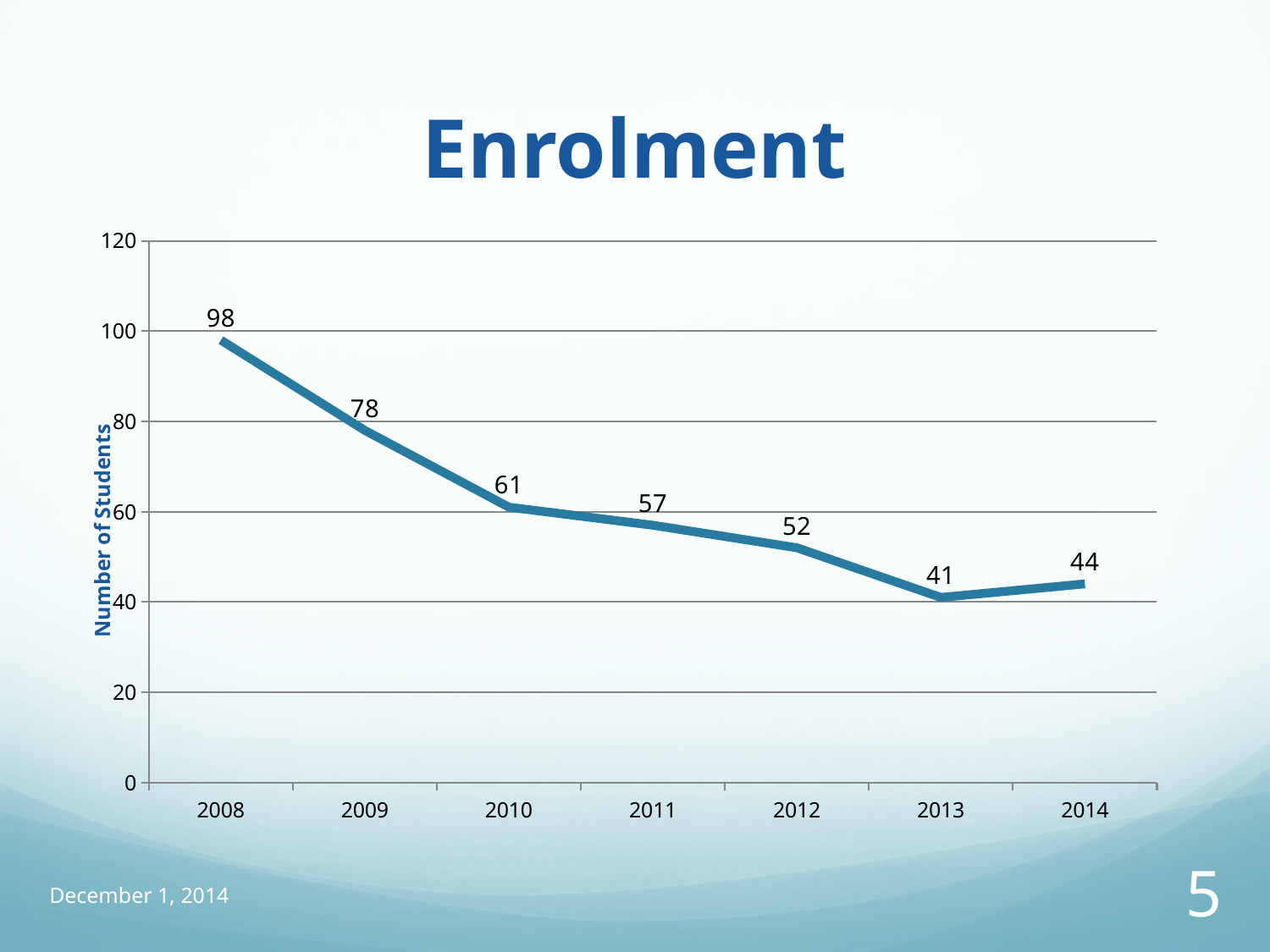
Is the value for 2009 greater or less than 80? less What is the number of students in 2014? 44 Which year has the highest number of students? 2008 Which year has more students, 2010 or 2012? 2010 What is the number of students in 2011? 57 How many years are plotted on the chart? 7 What is the difference in the number of students between 2008 and 2014? 54 What kind of chart is shown on the slide? Line chart What is the number of students in 2008? 98 What is the difference in the number of students between 2012 and 2013? 11 Which year has the lowest number of students? 2013 What is the label of the vertical axis? Number of Students